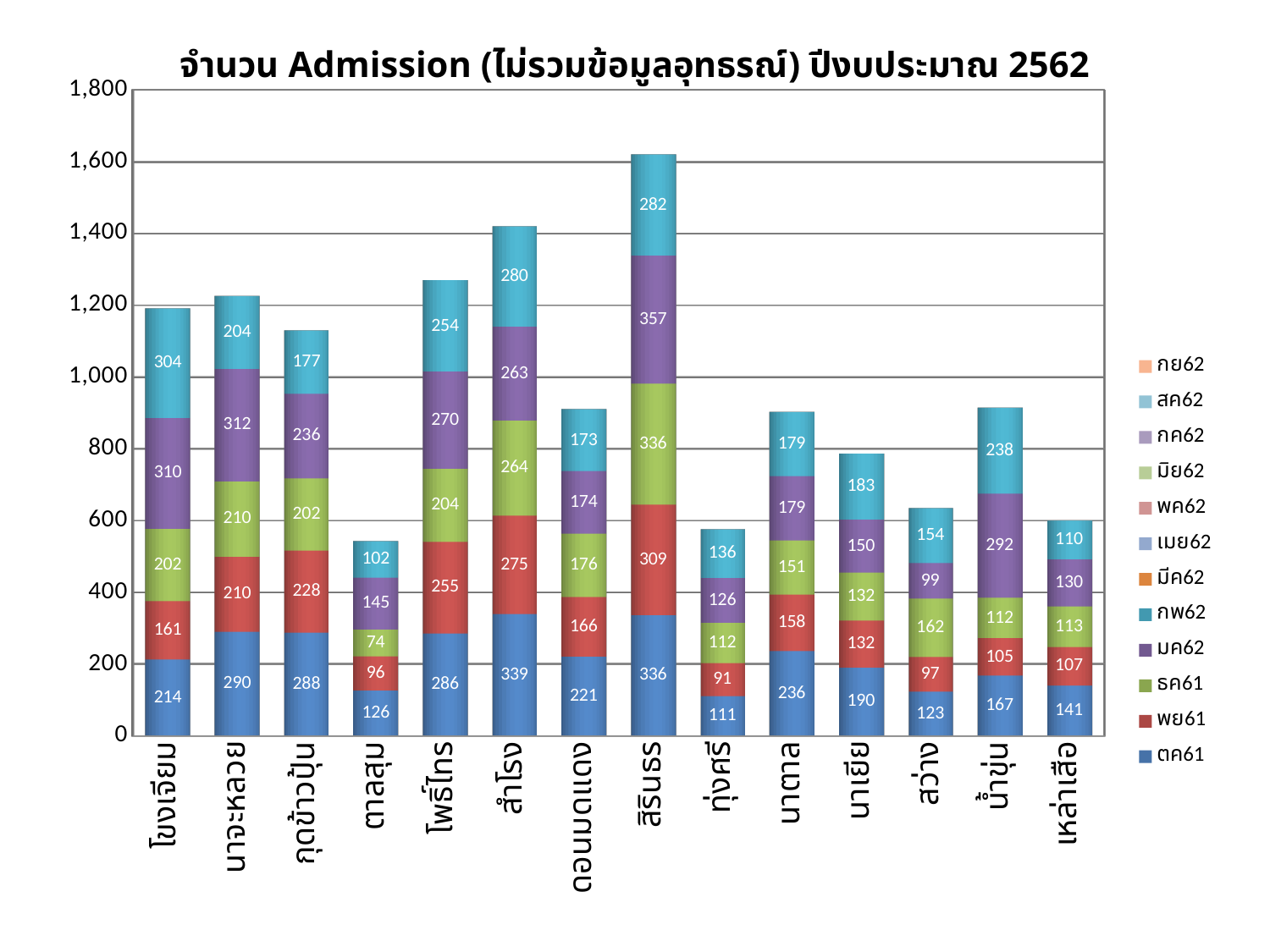
What is the ตค61 value for สิรินธร? 336 What is the กพ62 value for โขงเจียม? 304 Is the total stacked bar for นาเยีย greater or less than 800? less What is the มค62 value for น้ำขุ่น? 292 Which is larger, the พย61 value for โพธิ์ไทร or the พย61 value for กุดข้าวปุ้น? โพธิ์ไทร Which category has the tallest stacked bar overall? สิรินธร How many series does the legend list? 12 Which category has the shortest stacked bar overall? ตาลสุม What is the total of the stacked bar for สิรินธร? 1,620 What kind of chart is shown on the slide? Stacked bar chart How many categories are shown on the x axis? 14 What is the difference between the ตค61 values for สำโรง and ทุ่งศรี? 228